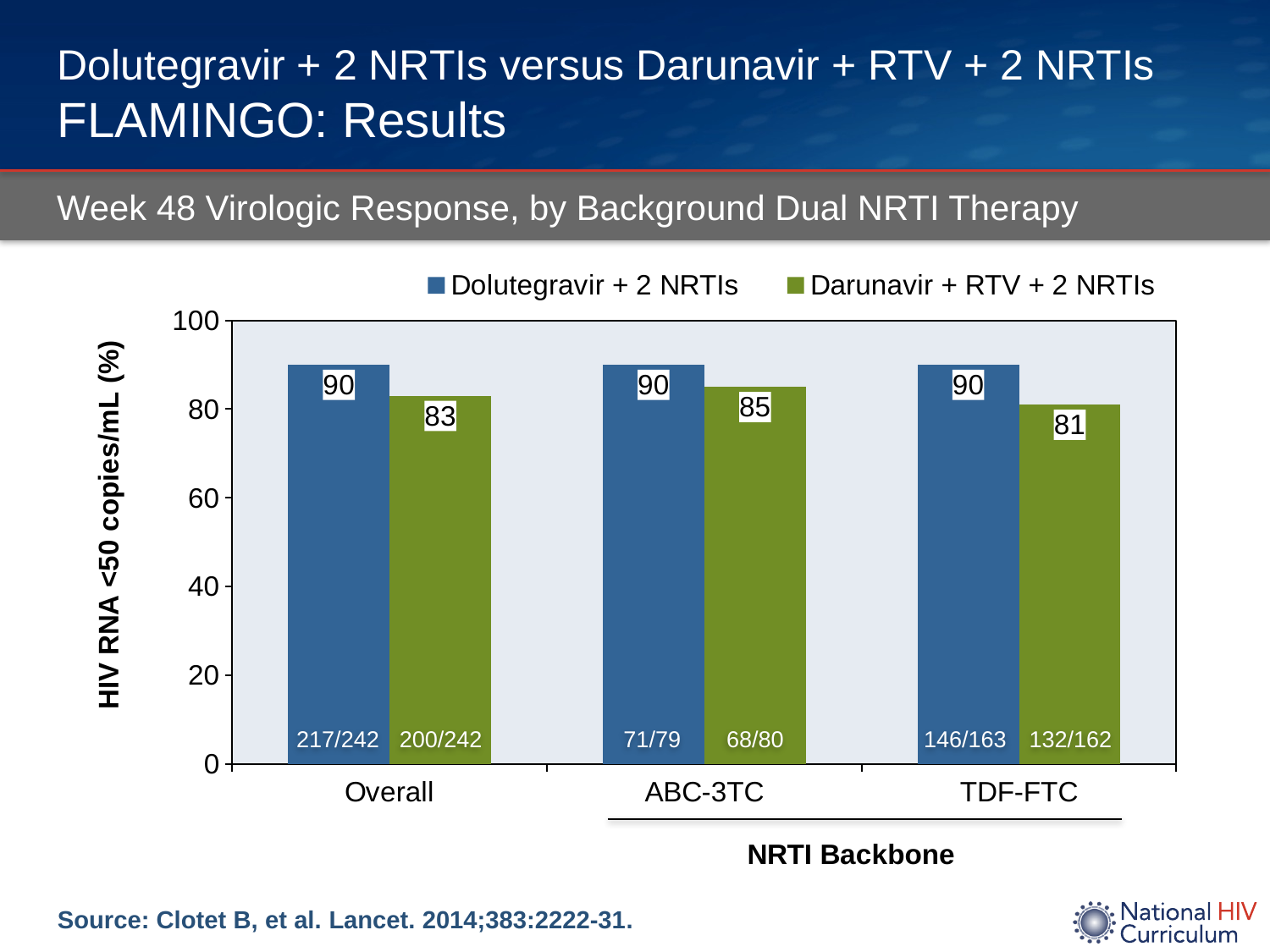
What kind of chart is shown on the slide? Bar chart What is the label of the y axis? HIV RNA <50 copies/mL (%) What is the difference between the Dolutegravir + 2 NRTIs and Darunavir + RTV + 2 NRTIs values in the TDF-FTC category? 9 What is the value for Dolutegravir + 2 NRTIs in the Overall category? 90 What is the value for Darunavir + RTV + 2 NRTIs in the TDF-FTC category? 81 What is the difference between the Dolutegravir + 2 NRTIs and Darunavir + RTV + 2 NRTIs values in the Overall category? 7 How many categories are shown on the x axis? 3 What is the value for Darunavir + RTV + 2 NRTIs in the ABC-3TC category? 85 Which category has the lowest value for Darunavir + RTV + 2 NRTIs? TDF-FTC In the ABC-3TC category, which series has the larger value? Dolutegravir + 2 NRTIs How many series does the legend list? 2 Is the value for Darunavir + RTV + 2 NRTIs in the Overall category greater or less than 80? greater